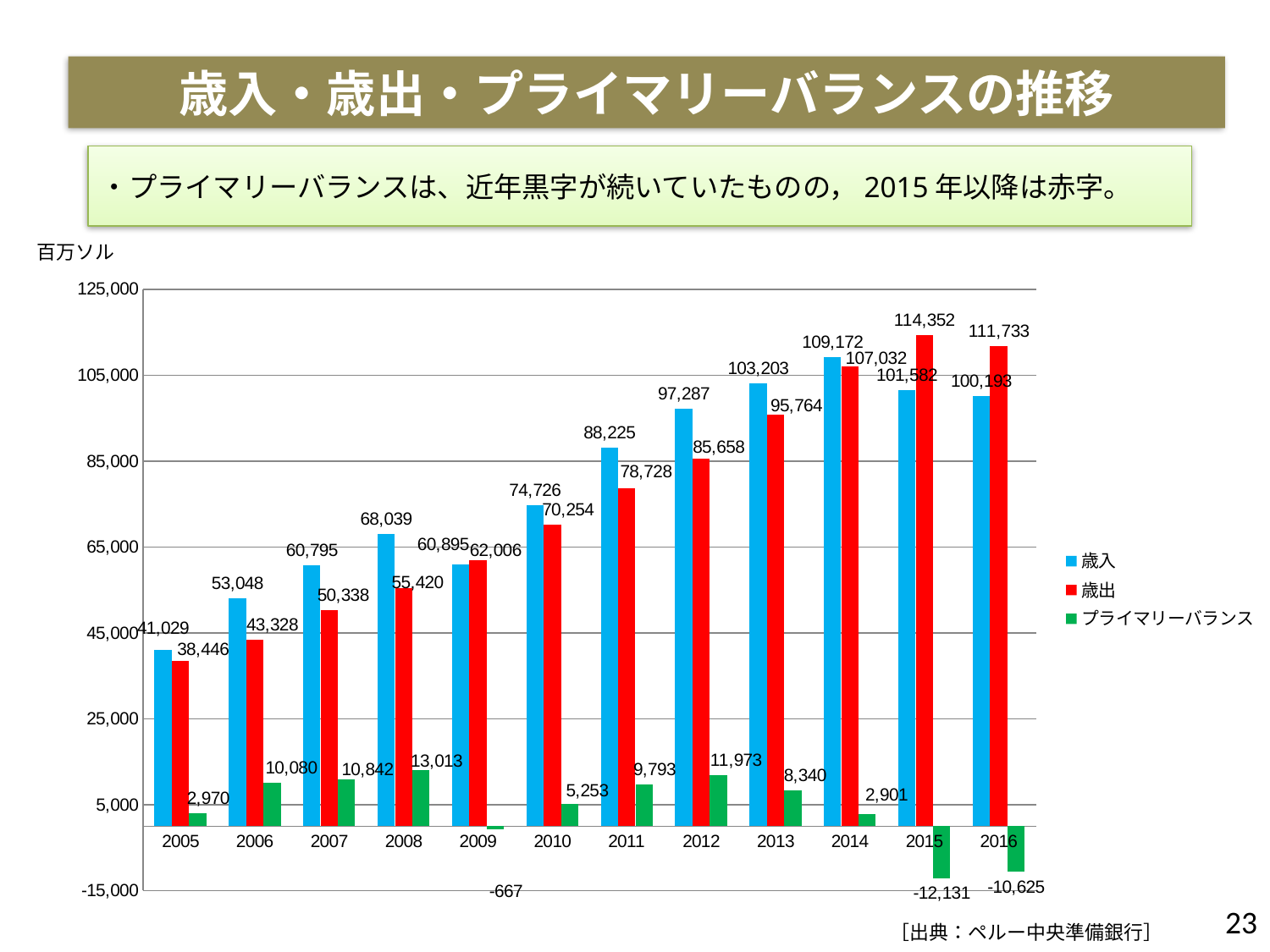
Does 歳入 rise or fall from 2005 to 2014? rise In 2009, which is larger, 歳入 or 歳出? 歳出 What kind of chart is shown on the slide? bar chart How many series does the legend list? 3 What is the value of プライマリーバランス for 2008? 13,013 Is the value of 歳入 for 2013 greater or less than 105,000? less What is the value of 歳入 for 2010? 74,726 What is the difference between 歳入 and 歳出 in 2011? 9,497 What is the value of 歳出 for 2012? 85,658 In which year is プライマリーバランス the lowest? 2015 How many years are shown on the x axis? 12 In which year is 歳出 the highest? 2015